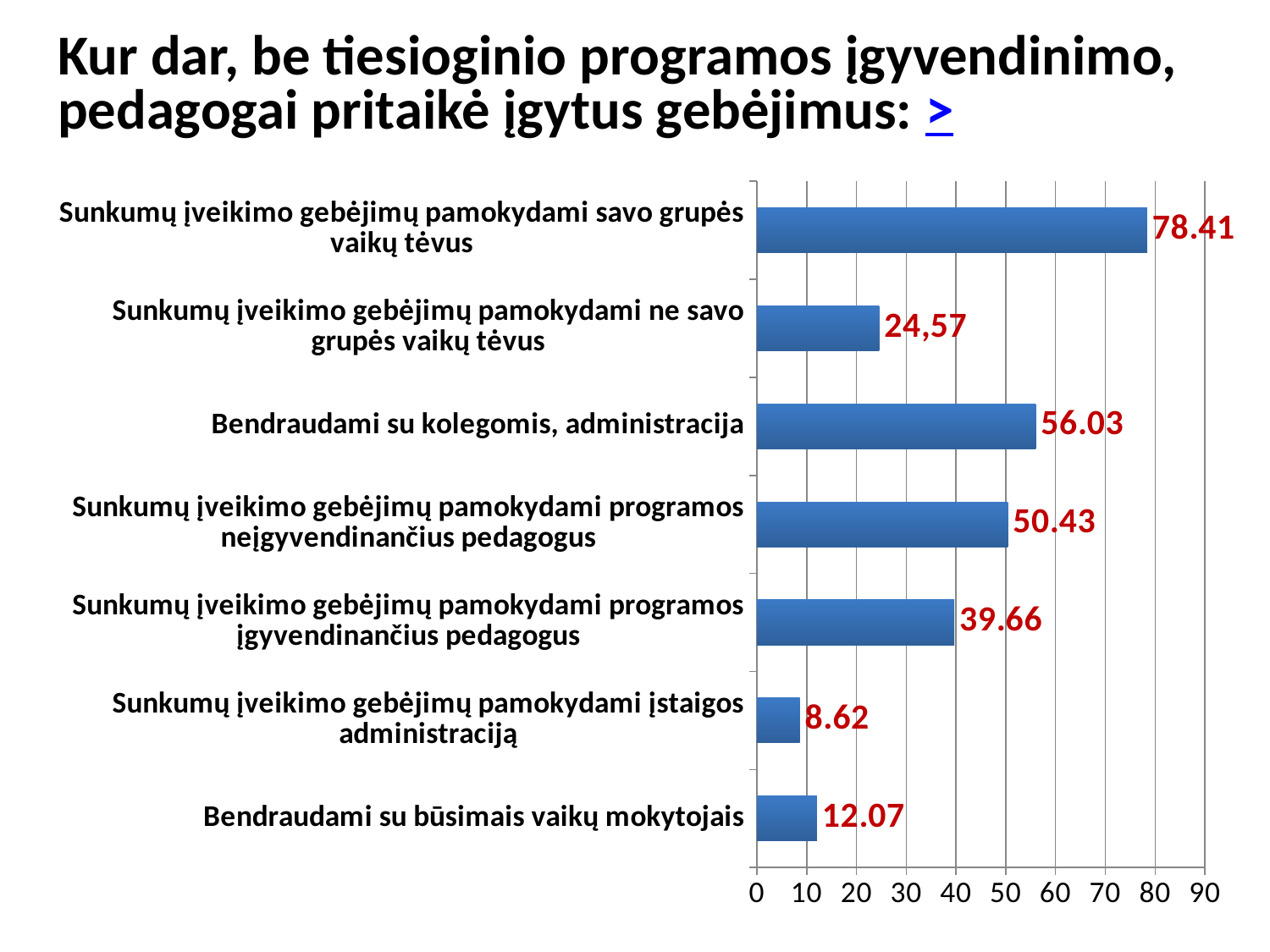
What is the value for "Bendraudami su būsimais vaikų mokytojais"? 12.07 Which category has the highest value? Sunkumų įveikimo gebėjimų pamokydami savo grupės vaikų tėvus What is the value for "Bendraudami su kolegomis, administracija"? 56.03 What type of chart is shown on the slide? bar chart What is the difference between the values for "Sunkumų įveikimo gebėjimų pamokydami programos neįgyvendinančius pedagogus" and "Sunkumų įveikimo gebėjimų pamokydami programos įgyvendinančius pedagogus"? 10.77 Which category has the lowest value? Sunkumų įveikimo gebėjimų pamokydami įstaigos administraciją Is the value for "Bendraudami su kolegomis, administracija" greater or less than 50? greater How many categories are shown in the chart? 7 What is the value for "Sunkumų įveikimo gebėjimų pamokydami savo grupės vaikų tėvus"? 78.41 Which is larger: the value for "Bendraudami su būsimais vaikų mokytojais" or for "Sunkumų įveikimo gebėjimų pamokydami įstaigos administraciją"? Bendraudami su būsimais vaikų mokytojais What is the maximum value shown on the horizontal axis? 90 What is the value for "Sunkumų įveikimo gebėjimų pamokydami ne savo grupės vaikų tėvus"? 24,57